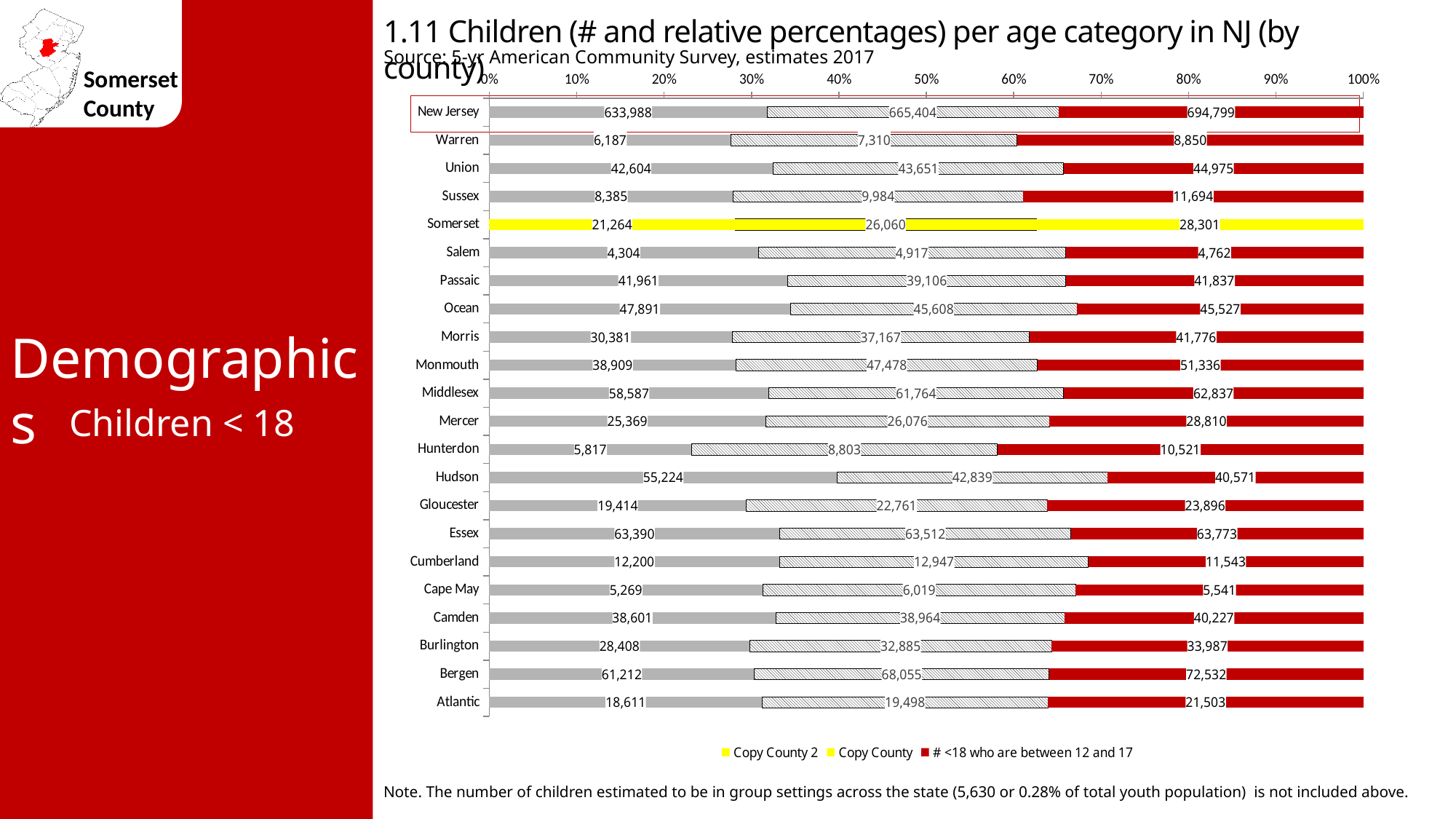
What is the value printed on the middle (hatched) segment of the Hudson bar? 42,839 What is the value printed on the leftmost (gray) segment of the New Jersey bar? 633,988 How many rows (counties plus the New Jersey total) are shown on the chart? 22 Which county has the lowest '# <18 who are between 12 and 17' value? Salem Is the share of the leftmost (gray) segment of the Hudson bar greater or less than 30%? greater What kind of chart is shown on the slide? Bar chart Excluding the New Jersey total row, which county has the highest '# <18 who are between 12 and 17' value? Bergen What is the total of the three segment values printed on the Somerset bar? 75,625 Which has a larger '# <18 who are between 12 and 17' value, Bergen or Essex? Bergen What is the value of the '# <18 who are between 12 and 17' segment for Somerset? 28,301 For Somerset, what is the difference between the '# <18 who are between 12 and 17' value (28,301) and the leftmost segment value (21,264)? 7,037 How many series does the legend list? 3